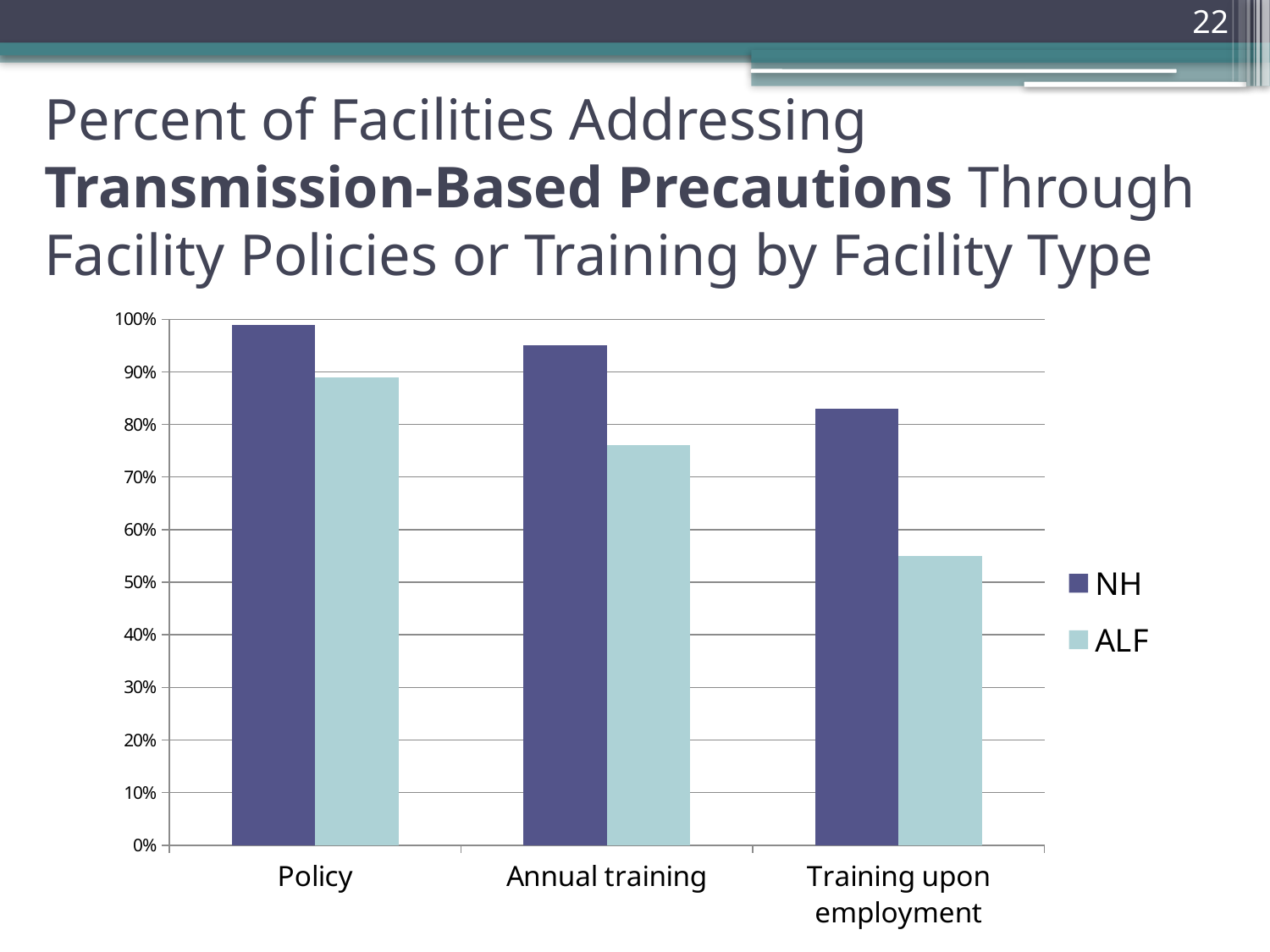
For which category is the ALF value lowest? Training upon employment How many series does the legend list? 2 For Training upon employment, which series has the larger value, NH or ALF? NH Do the ALF values rise or fall from Policy to Training upon employment? fall Is the NH value for Policy greater or less than 90%? greater Is the NH value for Annual training greater or less than 90%? greater Is the ALF value for Training upon employment greater or less than 60%? less For which category is the NH value highest? Policy How many categories are shown on the x axis? 3 What kind of chart is shown on the slide? bar chart